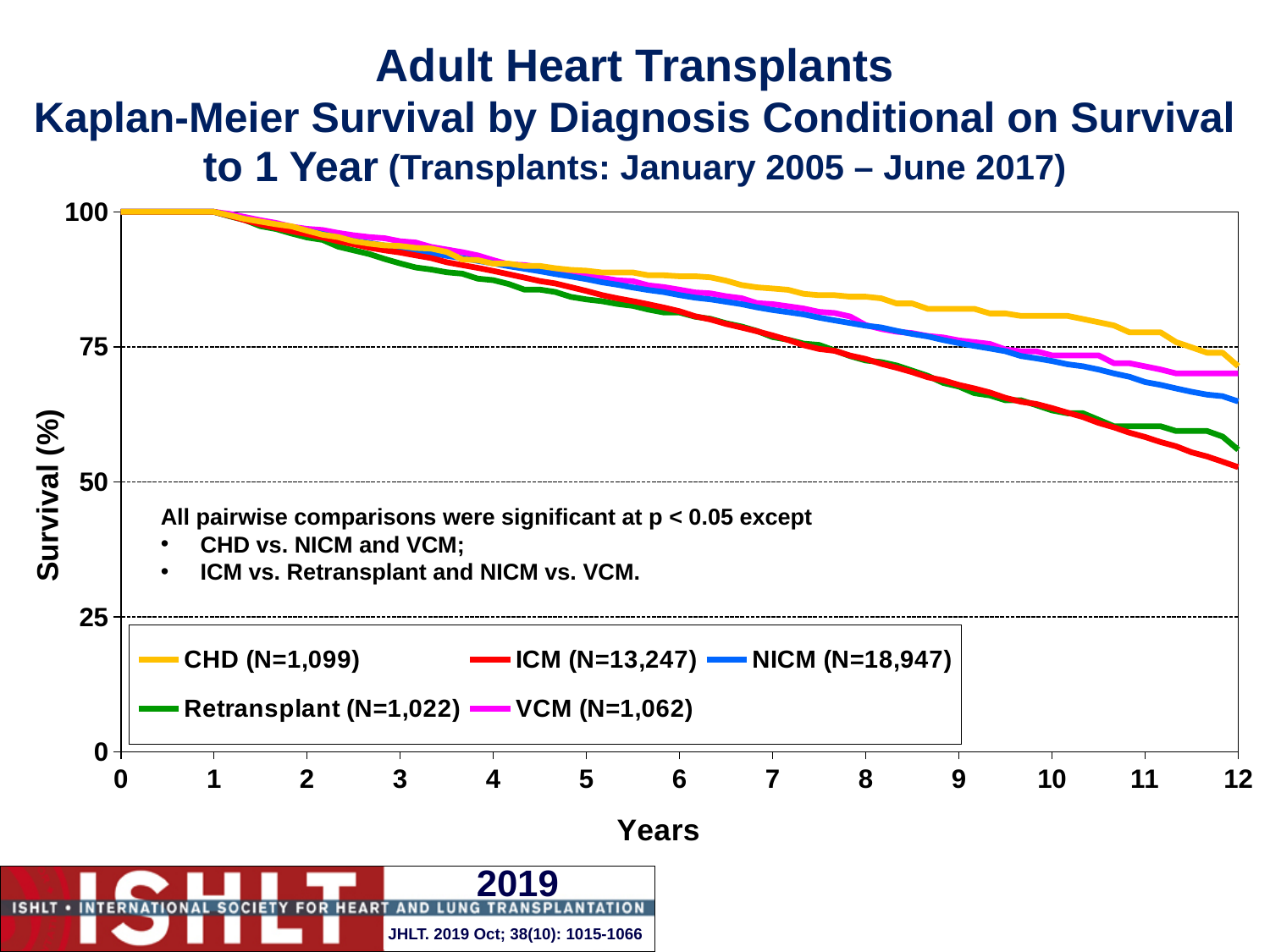
How many tick marks are labeled on the x axis (Years)? 13 Is the survival value for NICM at 12 years greater or less than 75? less Is the survival value for CHD at 6 years greater or less than 75? greater Is the survival value for ICM at 12 years greater or less than 75? less Do the survival curves rise or fall as years increase? fall At 12 years, which has higher survival, CHD or ICM? CHD At 10 years, which has higher survival, NICM or Retransplant? NICM What is the survival value for all series at year 0? 100 How many series does the legend list? 5 What type of chart is shown on the slide? line chart What is the label of the y axis? Survival (%)